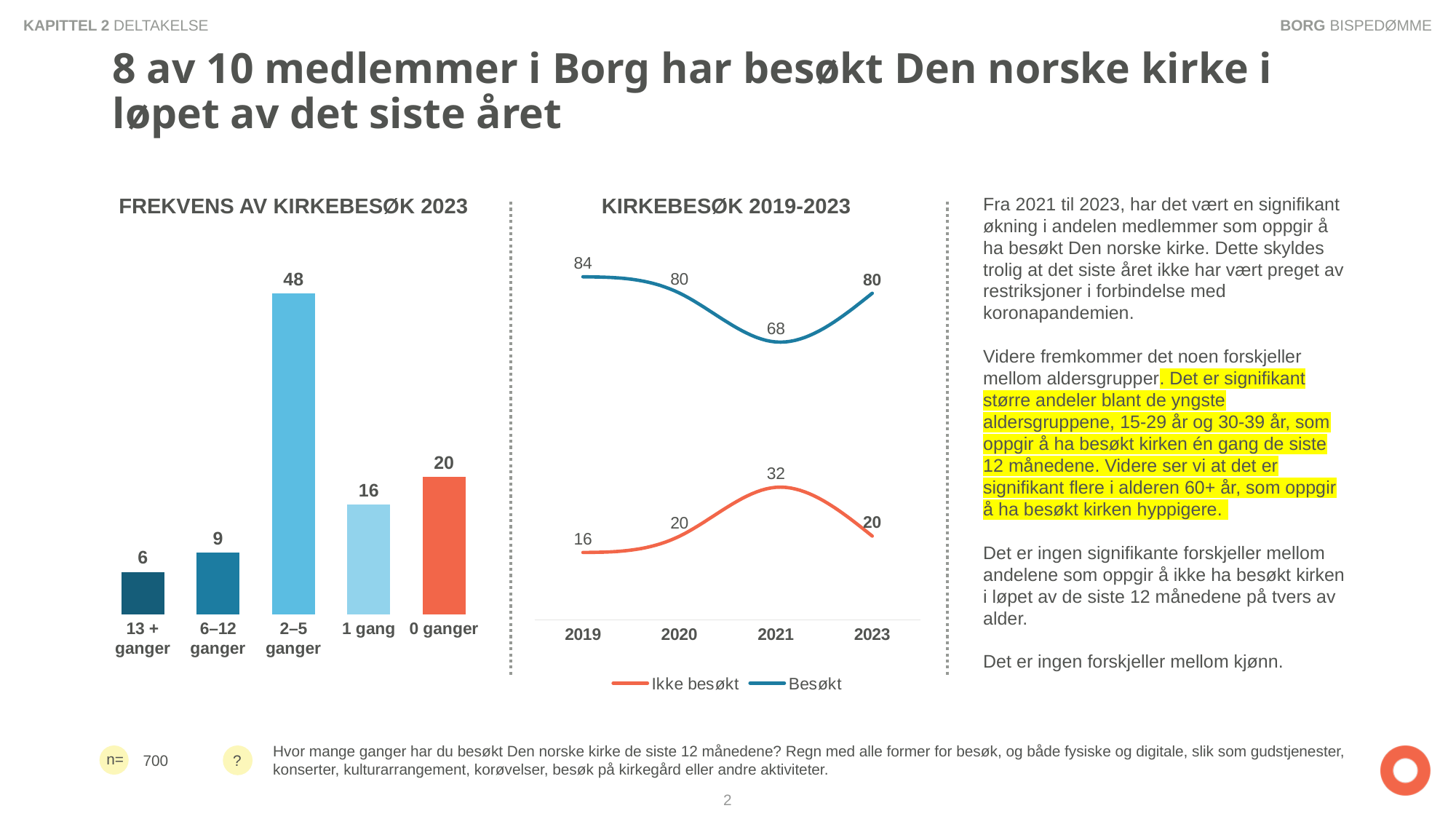
In the chart 'FREKVENS AV KIRKEBESØK 2023', what is the value for '2–5 ganger'? 48 In the chart 'KIRKEBESØK 2019-2023', which series has the larger value in 2023, 'Ikke besøkt' or 'Besøkt'? Besøkt In the chart 'KIRKEBESØK 2019-2023', what is the value for 'Ikke besøkt' in 2019? 16 In the chart 'FREKVENS AV KIRKEBESØK 2023', which category has the highest value? 2–5 ganger In the chart 'FREKVENS AV KIRKEBESØK 2023', how many categories are shown? 5 In the chart 'KIRKEBESØK 2019-2023', what is the difference between the 'Besøkt' values for 2019 and 2021? 16 What kind of chart is 'FREKVENS AV KIRKEBESØK 2023'? Bar chart In the chart 'KIRKEBESØK 2019-2023', what is the value for 'Besøkt' in 2021? 68 What kind of chart is 'KIRKEBESØK 2019-2023'? Line chart In the chart 'KIRKEBESØK 2019-2023', how many series does the legend list? 2 In the chart 'FREKVENS AV KIRKEBESØK 2023', which category has the lowest value? 13 + ganger In the chart 'FREKVENS AV KIRKEBESØK 2023', what is the difference between the values for '0 ganger' and '1 gang'? 4